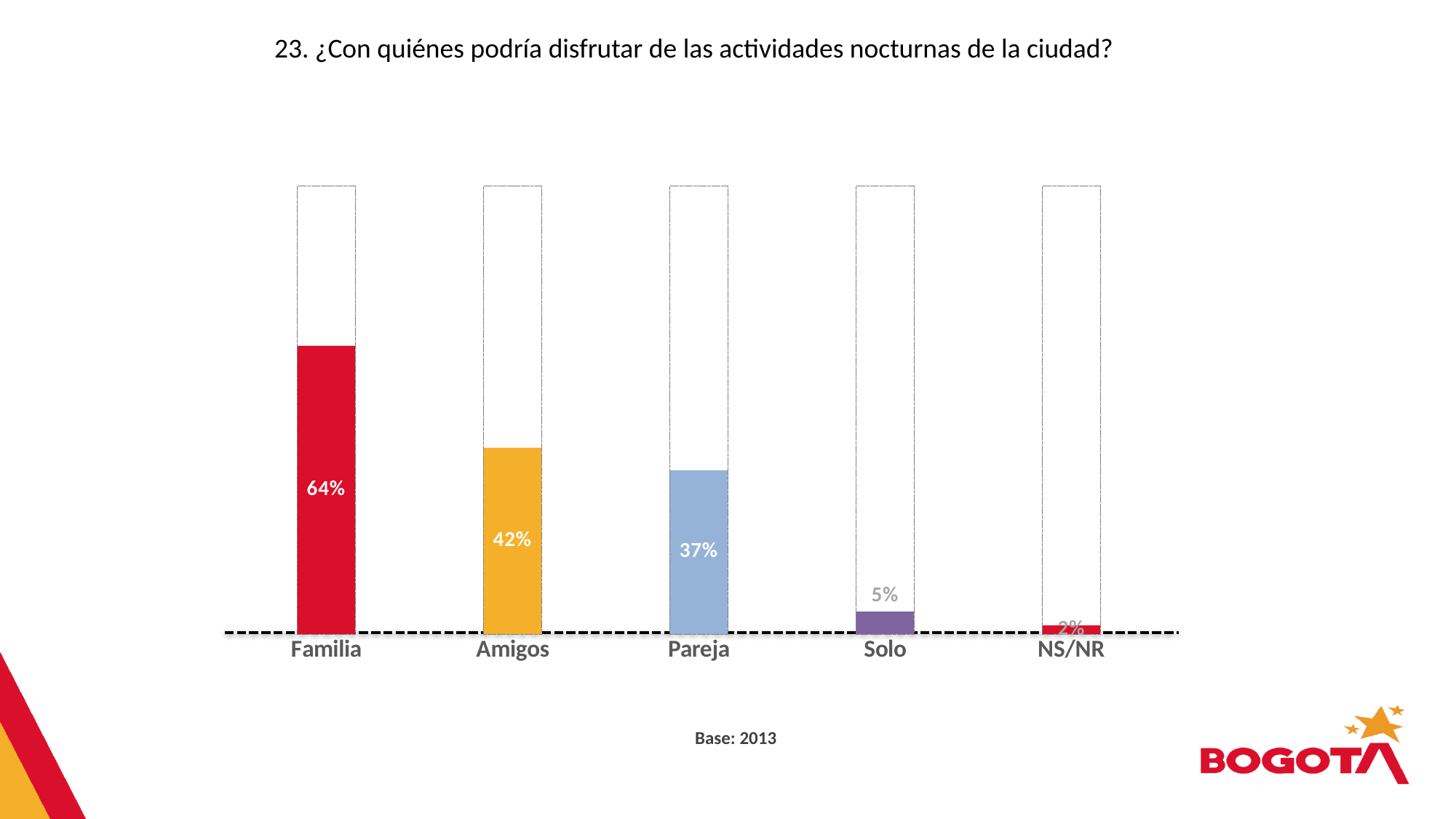
Which category has the highest value? Familia What is the difference between the values for Familia and Amigos? 22% What kind of chart is shown on the slide? Bar chart What is the value for Solo? 5% What is the value for Pareja? 37% Which category has the lowest value? NS/NR What base is stated below the chart? Base: 2013 What is the value for NS/NR? 2% What is the value for Amigos? 42% Which is larger, the value for Amigos or the value for Pareja? Amigos How many categories are shown on the chart? 5 What is the value for Familia? 64%